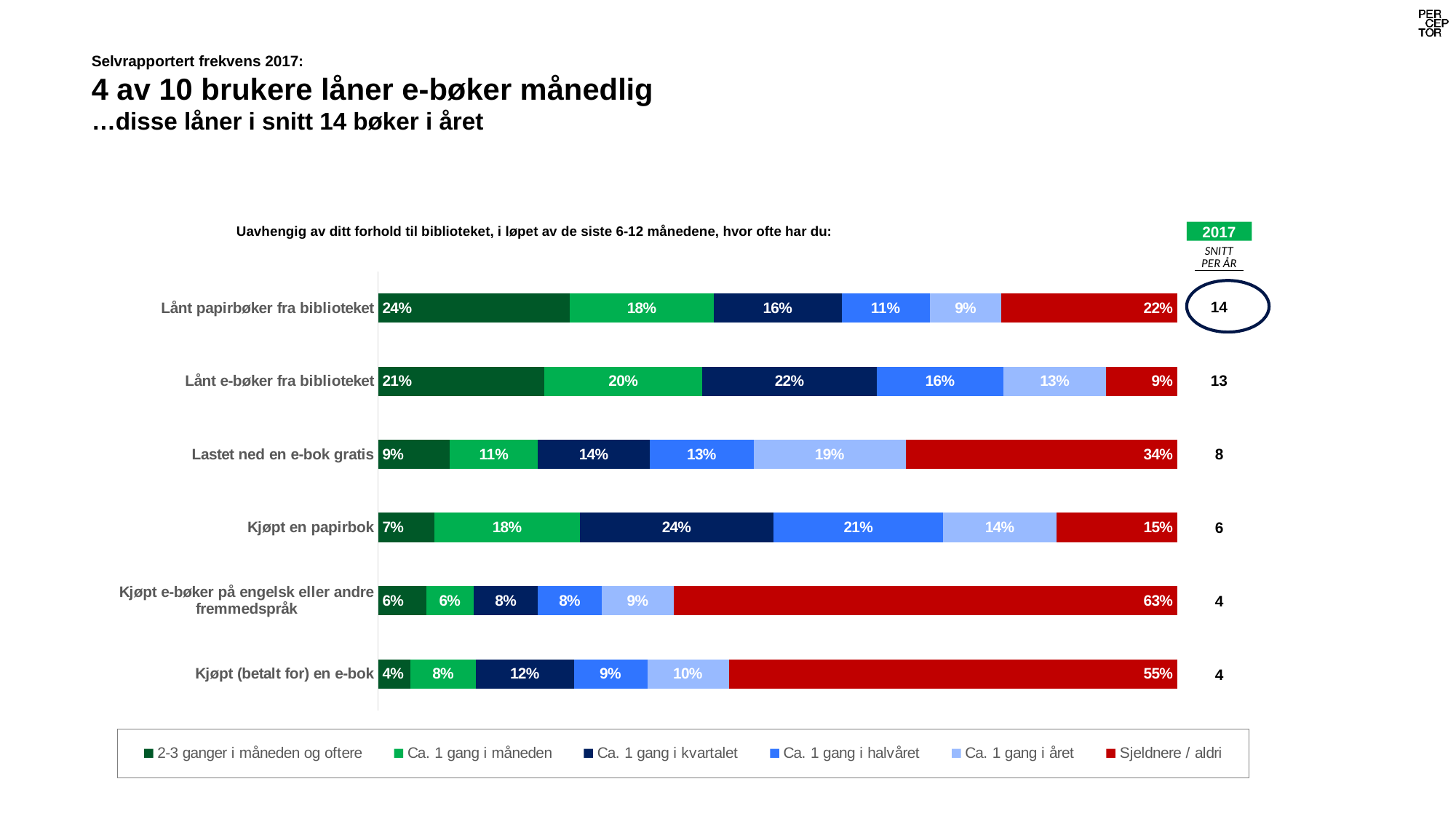
How many categories (bars) are shown in the chart? 6 What is the "Snitt per år" figure shown for "Lånt e-bøker fra biblioteket"? 13 Which category has the highest "Sjeldnere / aldri" share? Kjøpt e-bøker på engelsk eller andre fremmedspråk What kind of chart is shown on the slide? Stacked bar chart What is the value for "Ca. 1 gang i kvartalet" in the "Kjøpt en papirbok" bar? 24% Which is larger: the "Ca. 1 gang i måneden" value for "Lånt e-bøker fra biblioteket" or for "Lastet ned en e-bok gratis"? Lånt e-bøker fra biblioteket What is the value for "2-3 ganger i måneden og oftere" in the "Lånt papirbøker fra biblioteket" bar? 24% What percentage of respondents answered "Sjeldnere / aldri" for "Kjøpt e-bøker på engelsk eller andre fremmedspråk"? 63% How many series does the legend list? 6 Which legend entry is shown in red? Sjeldnere / aldri What is the difference between the "Sjeldnere / aldri" values for "Lastet ned en e-bok gratis" and "Lånt e-bøker fra biblioteket"? 25 percentage points Which category has the lowest "2-3 ganger i måneden og oftere" share? Kjøpt (betalt for) en e-bok